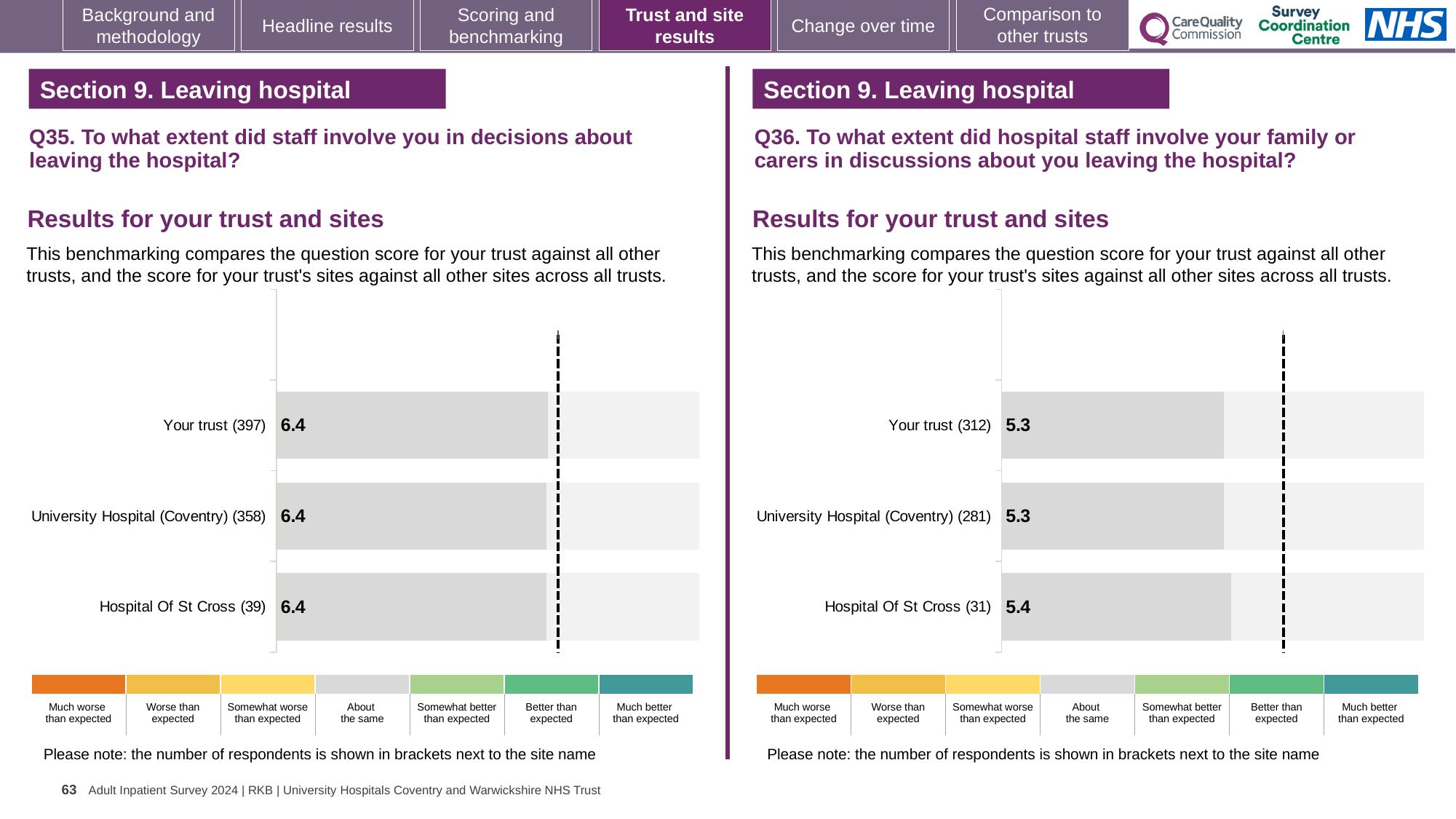
In the Q35 chart on the left, what is the score for Your trust? 6.4 In the Q35 chart on the left, what is the score for Hospital Of St Cross? 6.4 In the Q36 chart on the right, which site has the highest score? Hospital Of St Cross In the Q35 chart on the left, how many bars are plotted? 3 In the Q36 chart on the right, what is the score for Hospital Of St Cross? 5.4 In the Q36 chart on the right, what is the score for Your trust? 5.3 In the Q36 chart on the right, what is the score for University Hospital (Coventry)? 5.3 In the Q36 chart on the right, what is the difference between the score for Hospital Of St Cross and the score for Your trust? 0.1 In the Q35 chart on the left, how many respondents are shown in brackets for Your trust? 397 In the Q36 chart on the right, how many respondents are shown in brackets for Hospital Of St Cross? 31 Is the score for Your trust in the Q35 chart on the left larger or smaller than the score for Your trust in the Q36 chart on the right? Larger What type of chart is used in the Q35 chart on the left? Bar chart